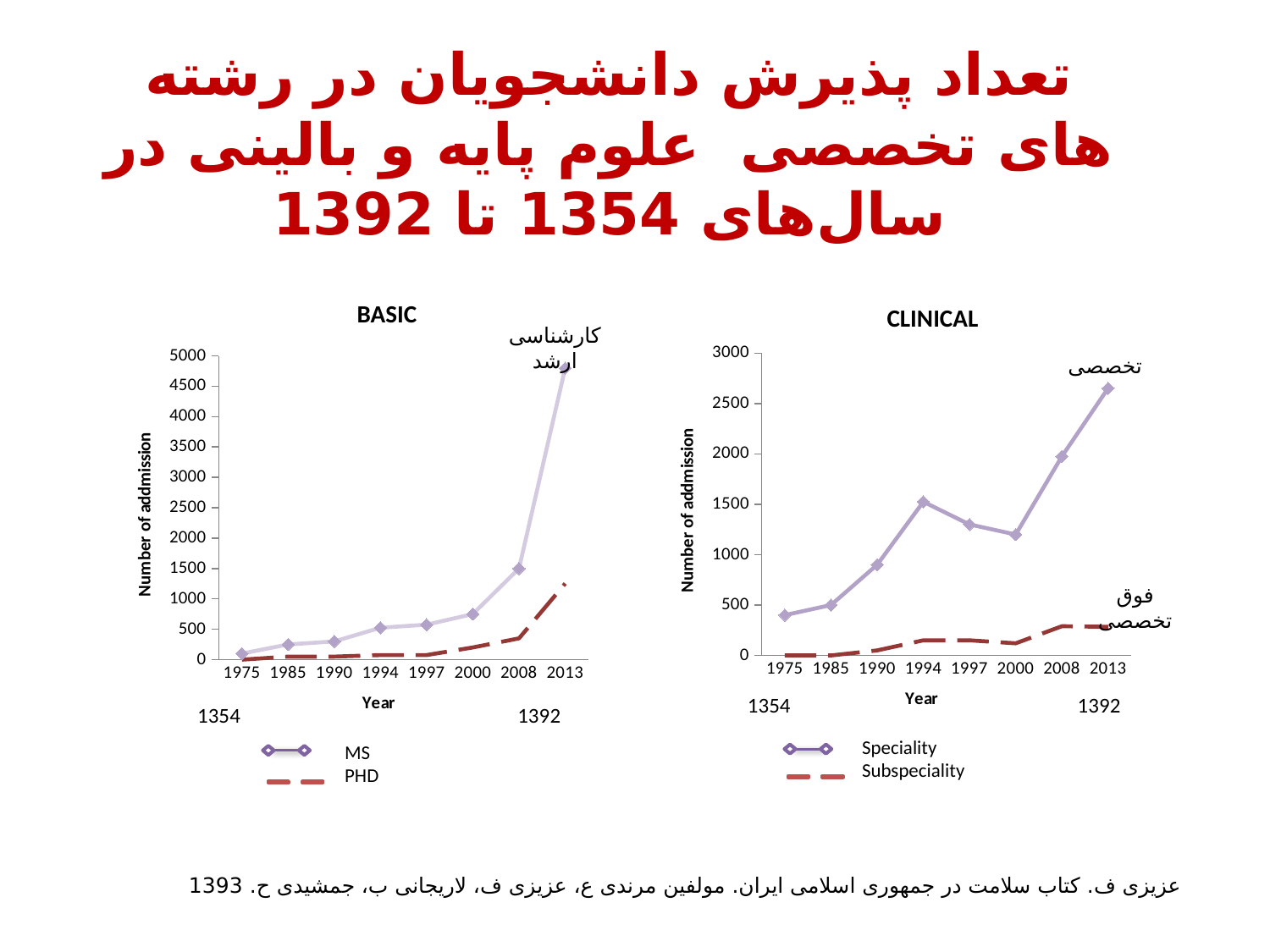
How many series does the legend of the CLINICAL chart list? 2 In the CLINICAL chart, is the Speciality value larger in 1994 or in 2000? 1994 What kind of chart is the BASIC chart? line chart In the BASIC chart, does the MS series generally rise or fall from 1975 to 2013? rise In the BASIC chart, is the MS value for 2013 greater or less than 4500? greater In the CLINICAL chart, is the Speciality value for 2013 greater or less than 2500? greater How many years are plotted along the x axis of the BASIC chart? 8 In the BASIC chart, is the MS value for 2008 greater or less than 1000? greater In the CLINICAL chart, in which year is the Speciality series lowest? 1975 In the CLINICAL chart, in which year is the Speciality series highest? 2013